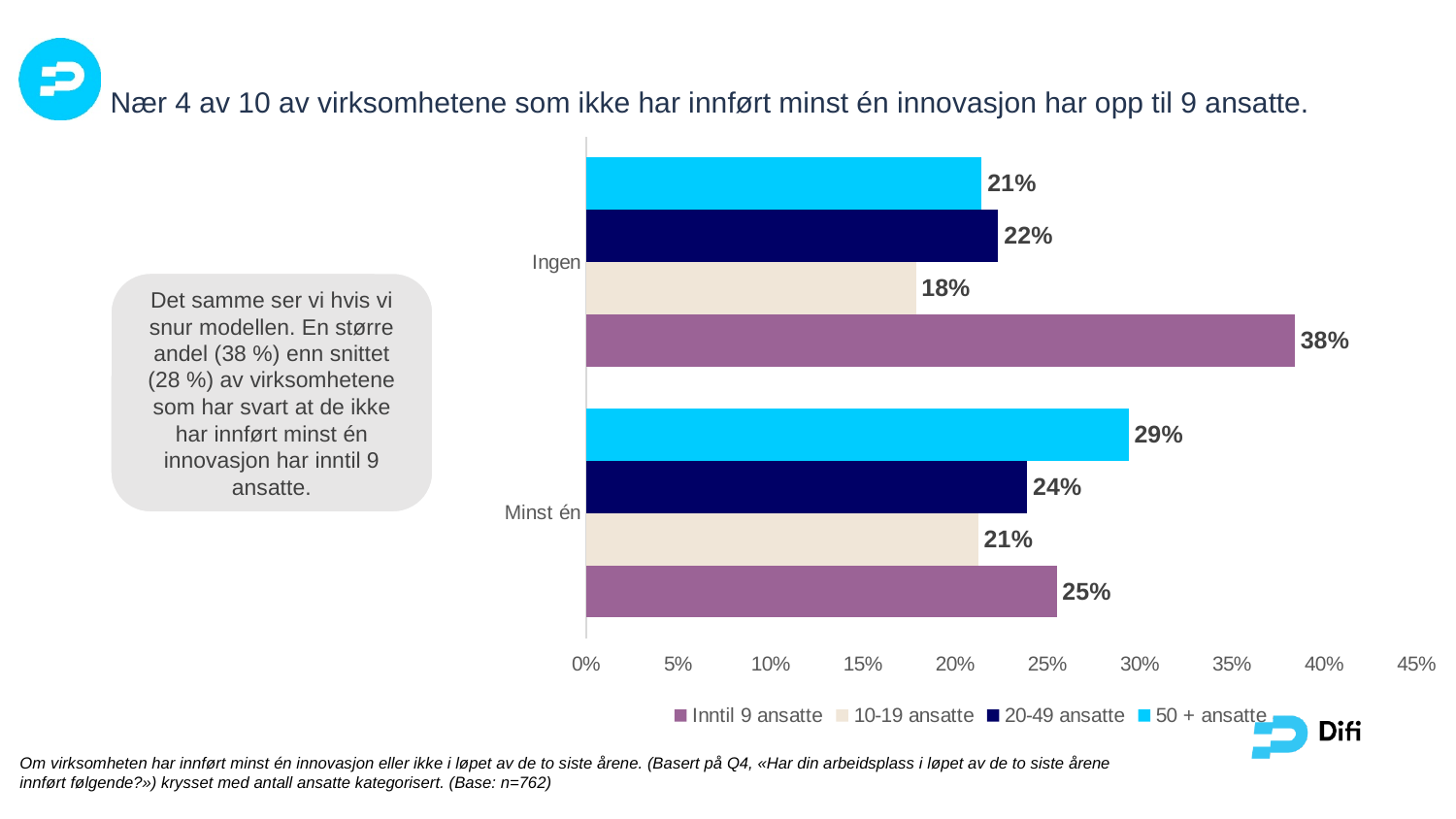
Which is larger: the '50 + ansatte' value for 'Ingen' or for 'Minst én'? Minst én What is the difference between the 'Inntil 9 ansatte' values for 'Ingen' and 'Minst én'? 13% How many series does the legend list? 4 What is the value for 'Inntil 9 ansatte' in the 'Ingen' category? 38% How many categories are shown on the vertical axis of the chart? 2 Which employee-size group has the highest value in the 'Ingen' category? Inntil 9 ansatte Which employee-size group has the lowest value in the 'Minst én' category? 10-19 ansatte What is the value for '10-19 ansatte' in the 'Ingen' category? 18% What is the value for '50 + ansatte' in the 'Minst én' category? 29% What is the value for '20-49 ansatte' in the 'Minst én' category? 24% What kind of chart is shown on the slide? Bar chart What is the maximum value shown on the horizontal axis of the chart? 45%